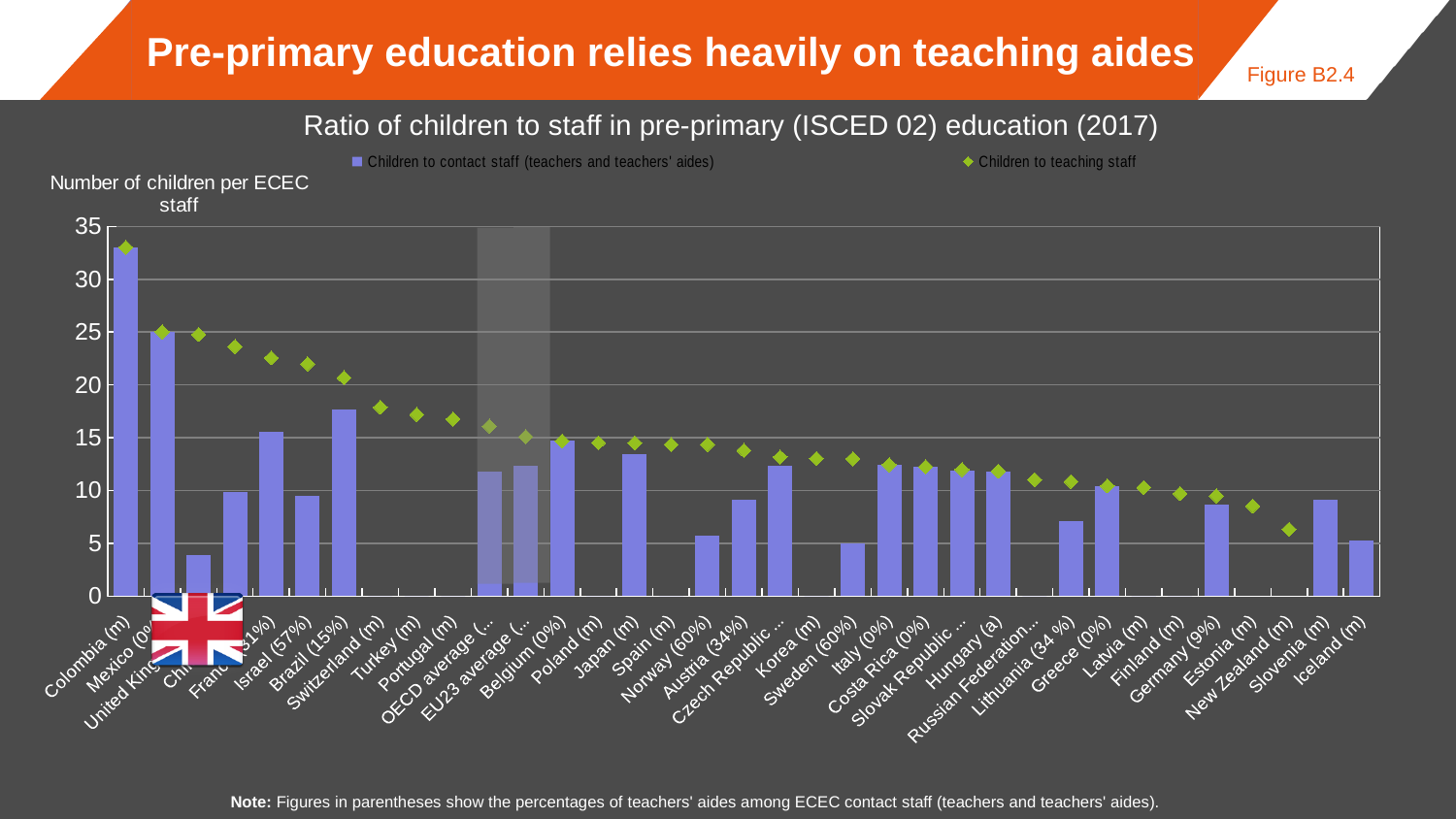
Is the value for children to teaching staff in Mexico (0%) greater or less than 20? greater Is the value for children to contact staff in Colombia (m) greater or less than 30? greater Is the value for children to contact staff in Norway (60%) greater or less than 10? less Which country has the lowest ratio of children to teaching staff? New Zealand (m) What is the label on the vertical axis of the chart? Number of children per ECEC staff How many series does the legend list? 2 Do the values for children to teaching staff generally rise or fall from left to right across the countries? fall What kind of chart is used to plot the 'Children to contact staff' series? bar chart Which has the higher ratio of children to contact staff, Israel (57%) or Brazil (15%)? Brazil (15%) Which country has the highest ratio of children to teaching staff? Colombia (m) What is the title of the chart? Ratio of children to staff in pre-primary (ISCED 02) education (2017)